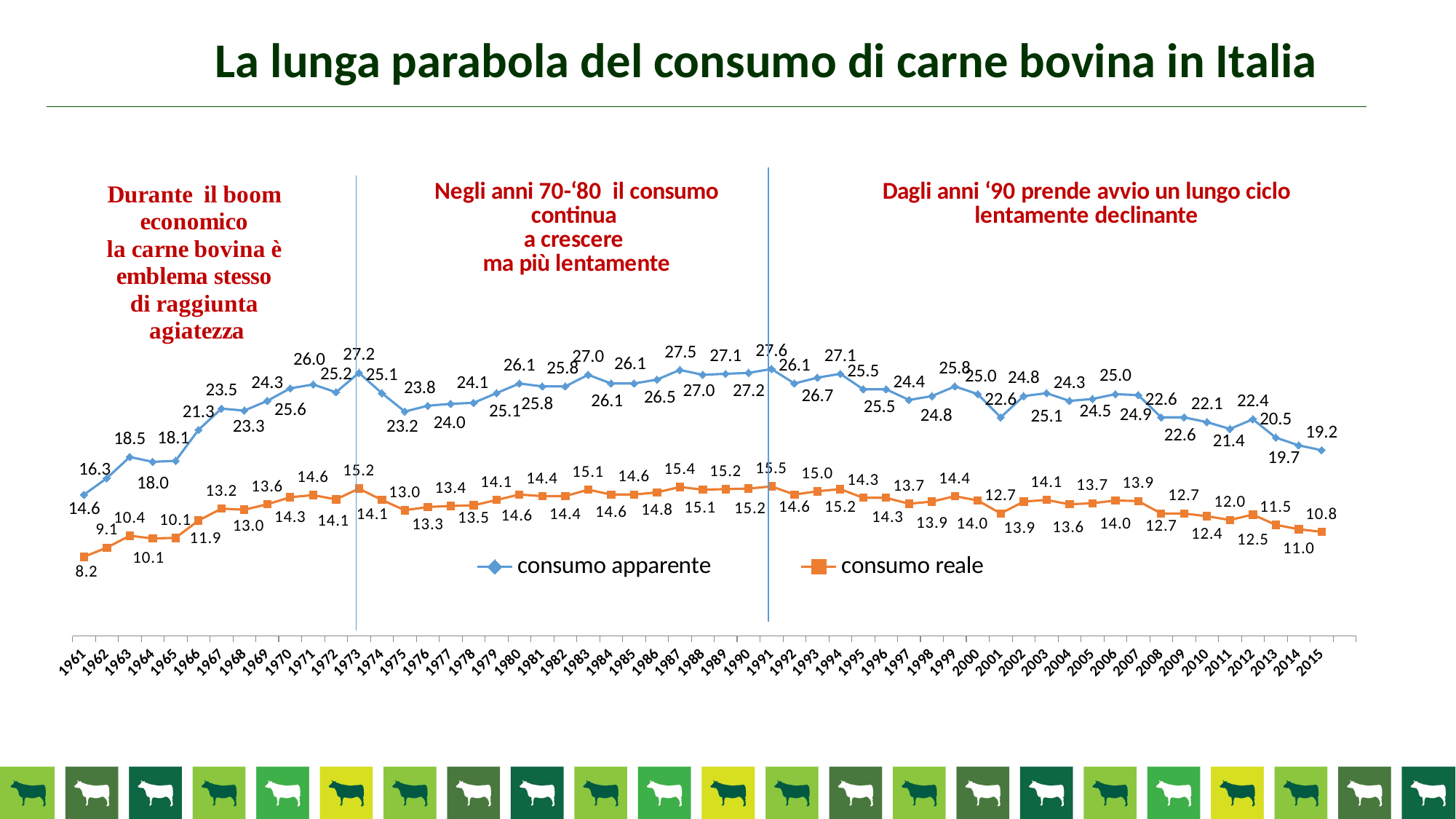
How many series does the legend list? 2 Which is larger, consumo apparente in 1991 or in 2015? 1991 What are the two series named in the legend? consumo apparente and consumo reale What is the difference between consumo apparente and consumo reale in 1973? 12.0 What is the value of consumo apparente in 1961? 14.6 What kind of chart is shown on the slide? Line chart What is the value of consumo reale in 2015? 10.8 How many years are shown on the x axis? 55 Does consumo apparente rise or fall from 1991 to 2015? Fall In which year is consumo reale at its lowest? 1961 In which year does consumo apparente reach its highest value? 1991 What is the value of consumo apparente in 1973? 27.2